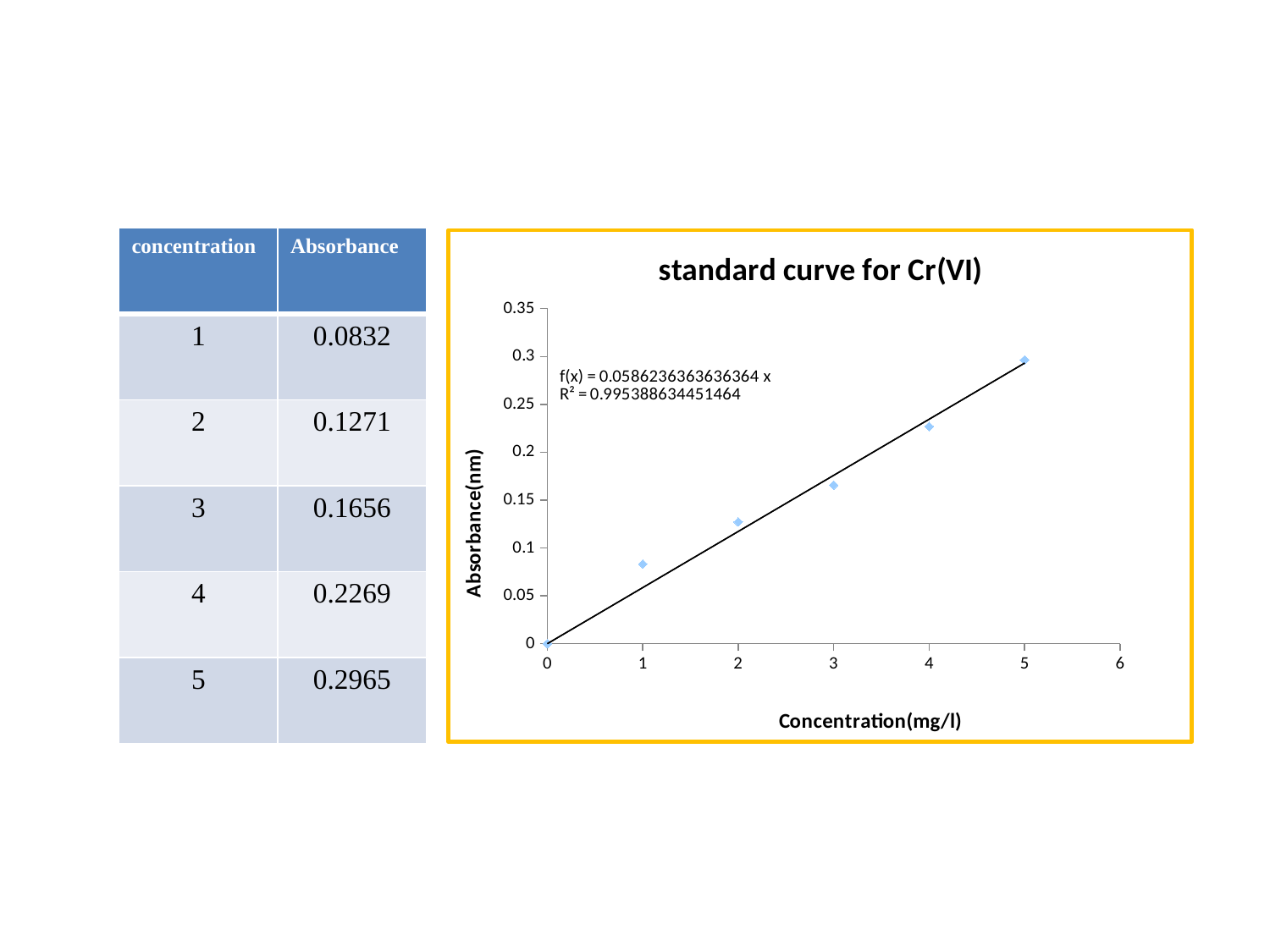
Which concentration in the table has the highest absorbance? 5 According to the table, what is the absorbance at a concentration of 3? 0.1656 What is the label of the x axis of the chart? Concentration(mg/l) What is the difference in absorbance between concentration 4 and concentration 2 in the table? 0.0998 According to the table, what is the absorbance at a concentration of 1? 0.0832 Is the absorbance at concentration 4 greater or less than 0.2 on the chart? greater What kind of chart is shown on the slide? scatter chart Which concentration in the table has the lowest absorbance? 1 How many data points are plotted on the chart? 6 What is the title of the chart? standard curve for Cr(VI) According to the table, what is the absorbance at a concentration of 5? 0.2965 Do the absorbance values rise or fall as concentration increases along the x axis? rise